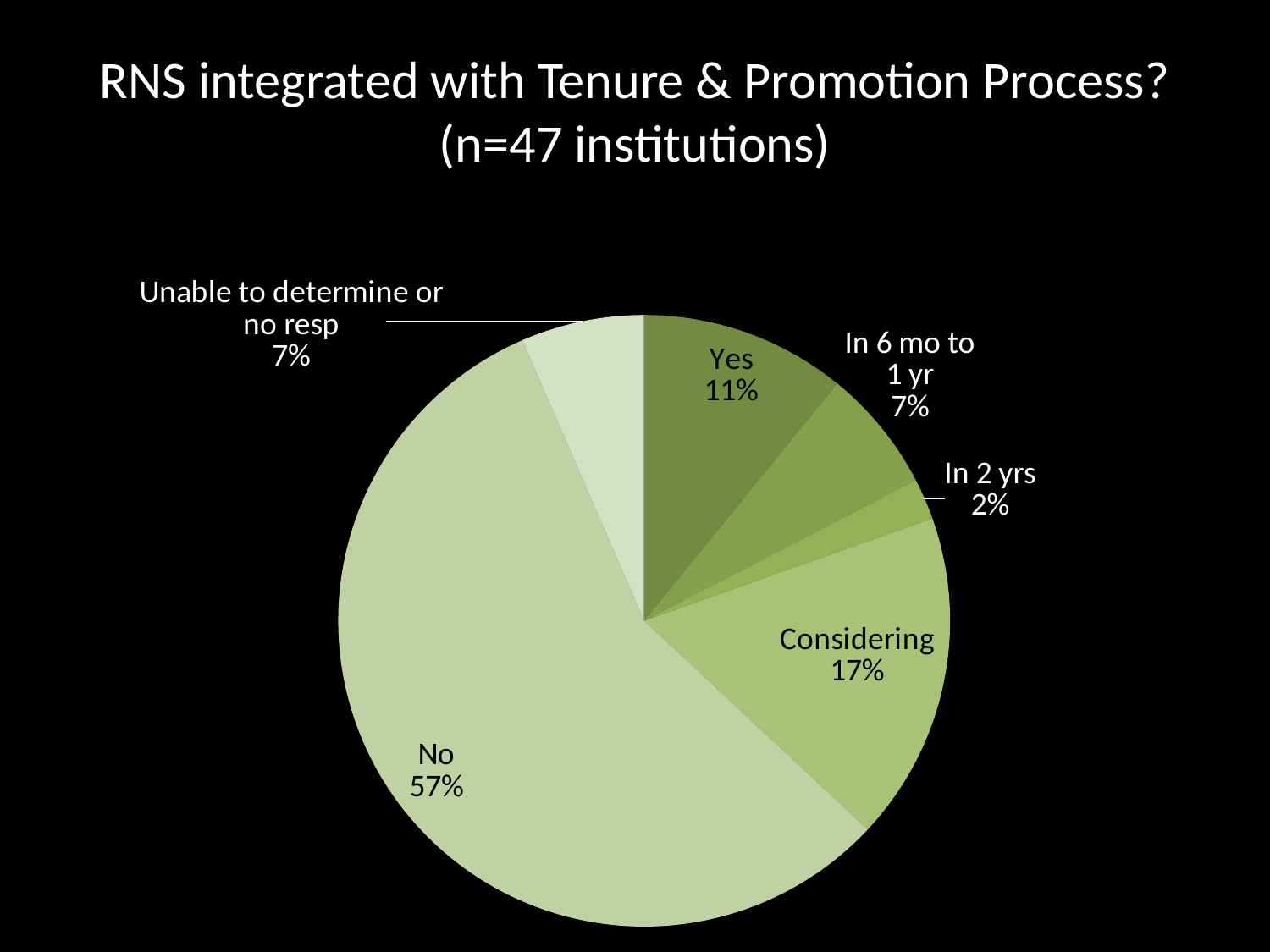
Which category has the smallest slice of the pie? In 2 yrs What is the title of the chart? RNS integrated with Tenure & Promotion Process? (n=47 institutions) What kind of chart is shown on the slide? pie chart Which is larger, the "Yes" slice or the "Considering" slice? Considering What percentage is shown for "In 2 yrs"? 2% What percentage is shown for "In 6 mo to 1 yr"? 7% How many slices does the pie chart have? 6 What share of the pie does the "No" slice represent? 57% Which category has the largest slice of the pie? No What is the difference in percentage points between "No" and "Considering"? 40 What percentage is shown for "Considering"? 17% What percentage is shown for "Yes"? 11%